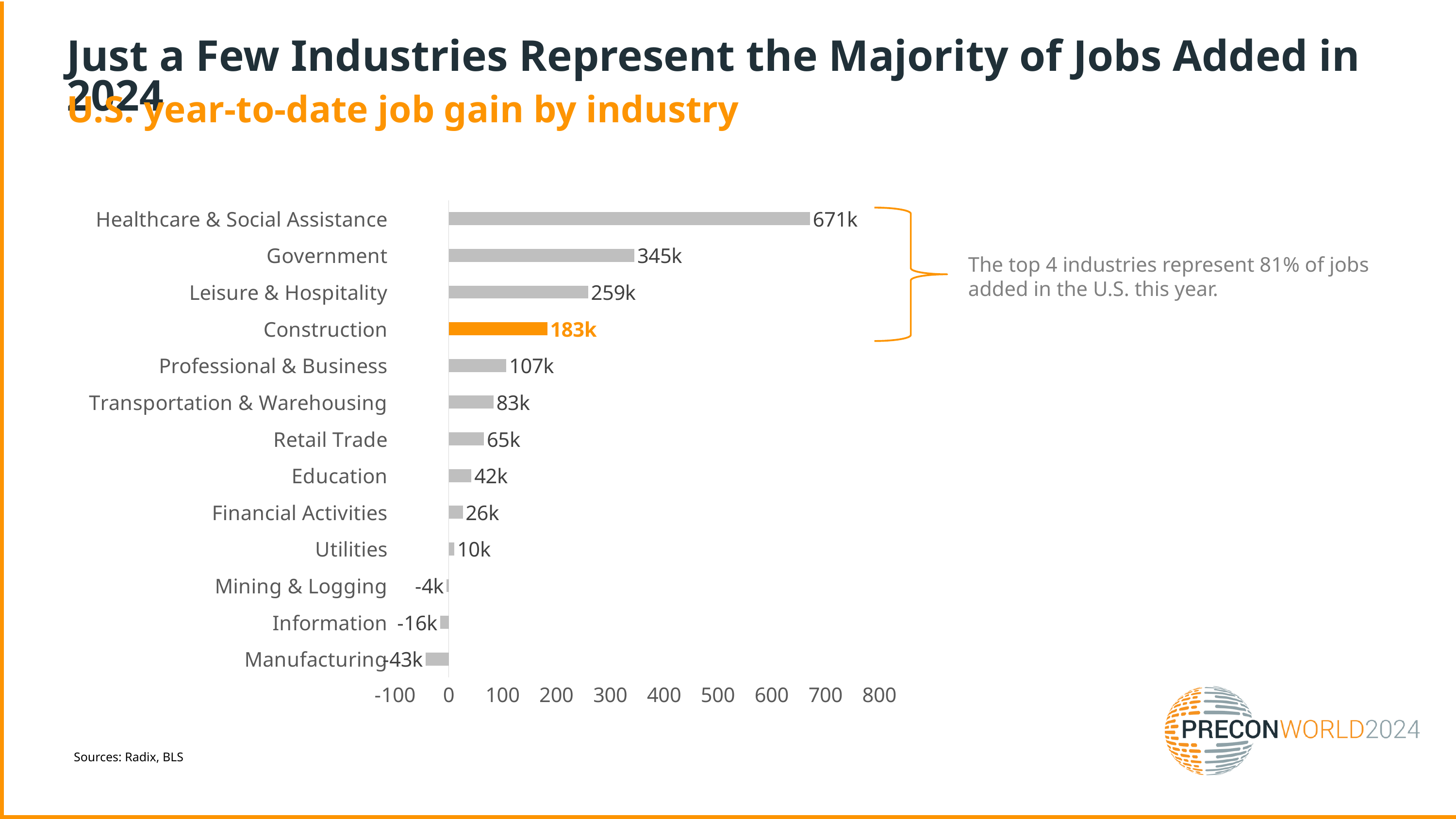
Which bar is highlighted in orange? Construction What is the year-to-date job gain for Construction? 183k Which has a larger job gain, Professional & Business or Transportation & Warehousing? Professional & Business What is the difference between the job gains for Government and Leisure & Hospitality? 86k Which industry has the lowest value on the chart? Manufacturing What is the value shown for Manufacturing? -43k What kind of chart is shown on the slide? Bar chart How many industries show a negative job gain? 3 What is the year-to-date job gain for Healthcare & Social Assistance? 671k According to the annotation, what share of jobs added in the U.S. this year do the top 4 industries represent? 81% How many industries are shown on the chart? 13 Which industry has the highest year-to-date job gain? Healthcare & Social Assistance